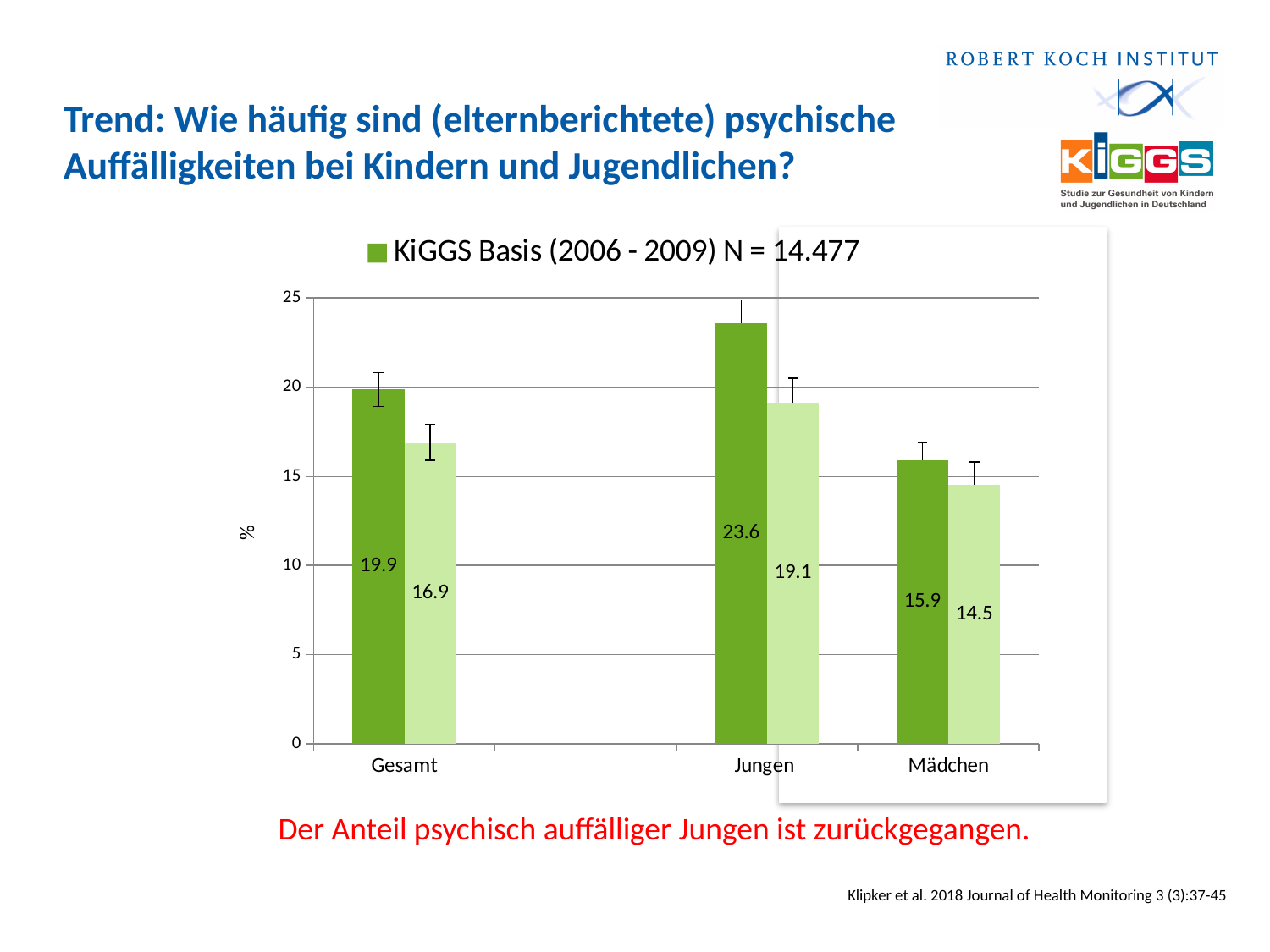
Which is larger: the KiGGS Basis (2006 - 2009) value for Jungen or for Mädchen? Jungen Which category has the lowest value on the light green bars? Mädchen What is the KiGGS Basis (2006 - 2009) value for Mädchen? 15.9 What value is shown on the light green bar for Mädchen? 14.5 For Jungen, what is the difference between the KiGGS Basis (2006 - 2009) value and the light green bar value? 4.5 What is the KiGGS Basis (2006 - 2009) value for Jungen? 23.6 How many categories are shown on the x axis? 3 What kind of chart is shown on the slide? Bar chart Which category has the highest KiGGS Basis (2006 - 2009) value? Jungen What value is shown on the light green bar for Jungen? 19.1 What is the KiGGS Basis (2006 - 2009) value for Gesamt? 19.9 What value is shown on the light green bar for Gesamt? 16.9